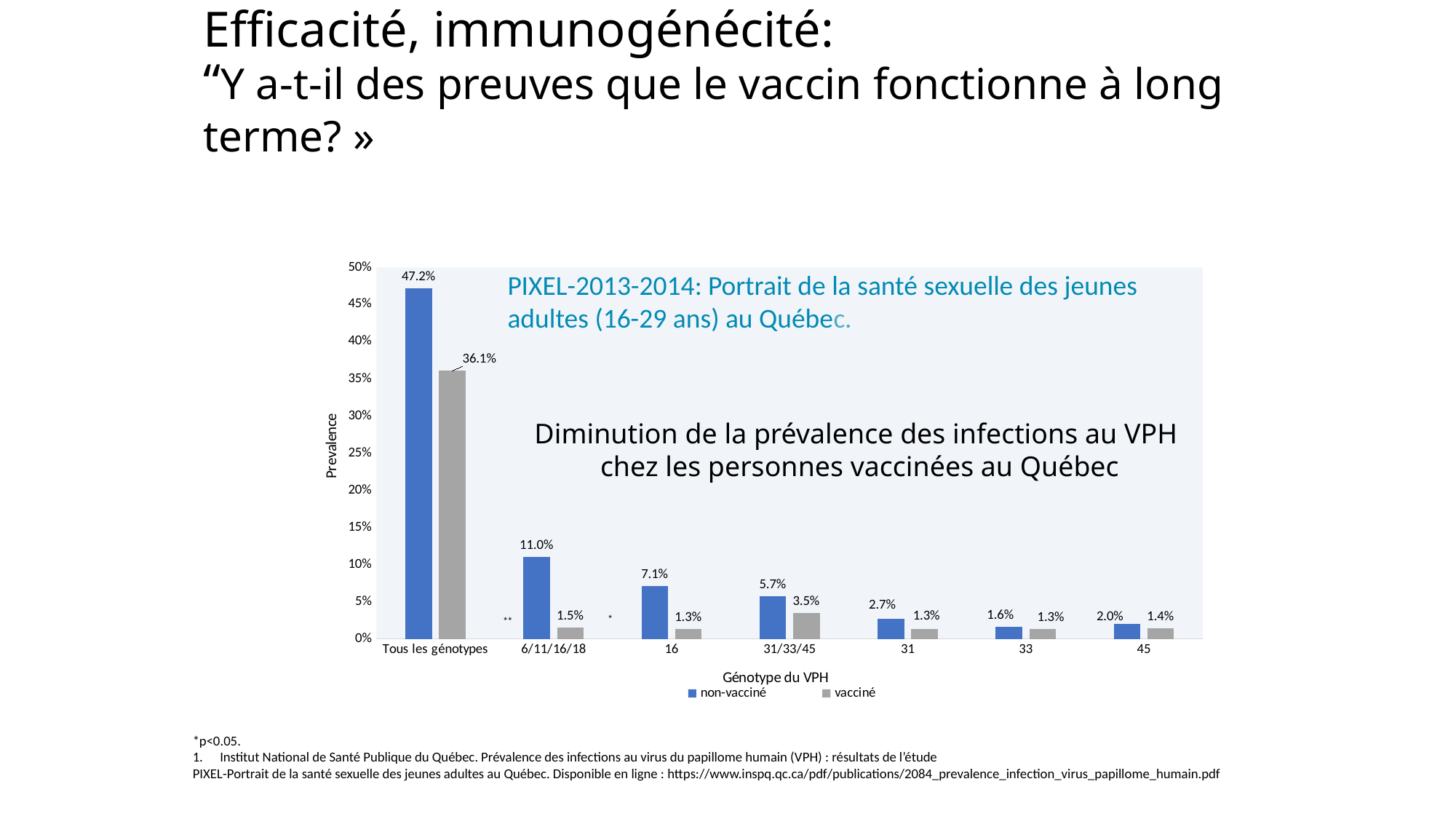
Which category has the highest non-vacciné prevalence? Tous les génotypes What is the difference between the non-vacciné and vacciné prevalence for genotype 6/11/16/18? 9.5% How many series does the legend list? 2 What is the prevalence for non-vacciné for genotype 16? 7.1% What is the difference between the non-vacciné and vacciné prevalence for 'Tous les génotypes'? 11.1% Which is larger for genotype 45: the non-vacciné or the vacciné prevalence? non-vacciné What is the prevalence for vacciné for genotype 31/33/45? 3.5% How many genotype categories are shown on the x axis? 7 What is the prevalence for vacciné in the '6/11/16/18' category? 1.5% What is the prevalence for non-vacciné in the 'Tous les génotypes' category? 47.2% Which category has the lowest non-vacciné prevalence? 33 What kind of chart is shown on the slide? bar chart